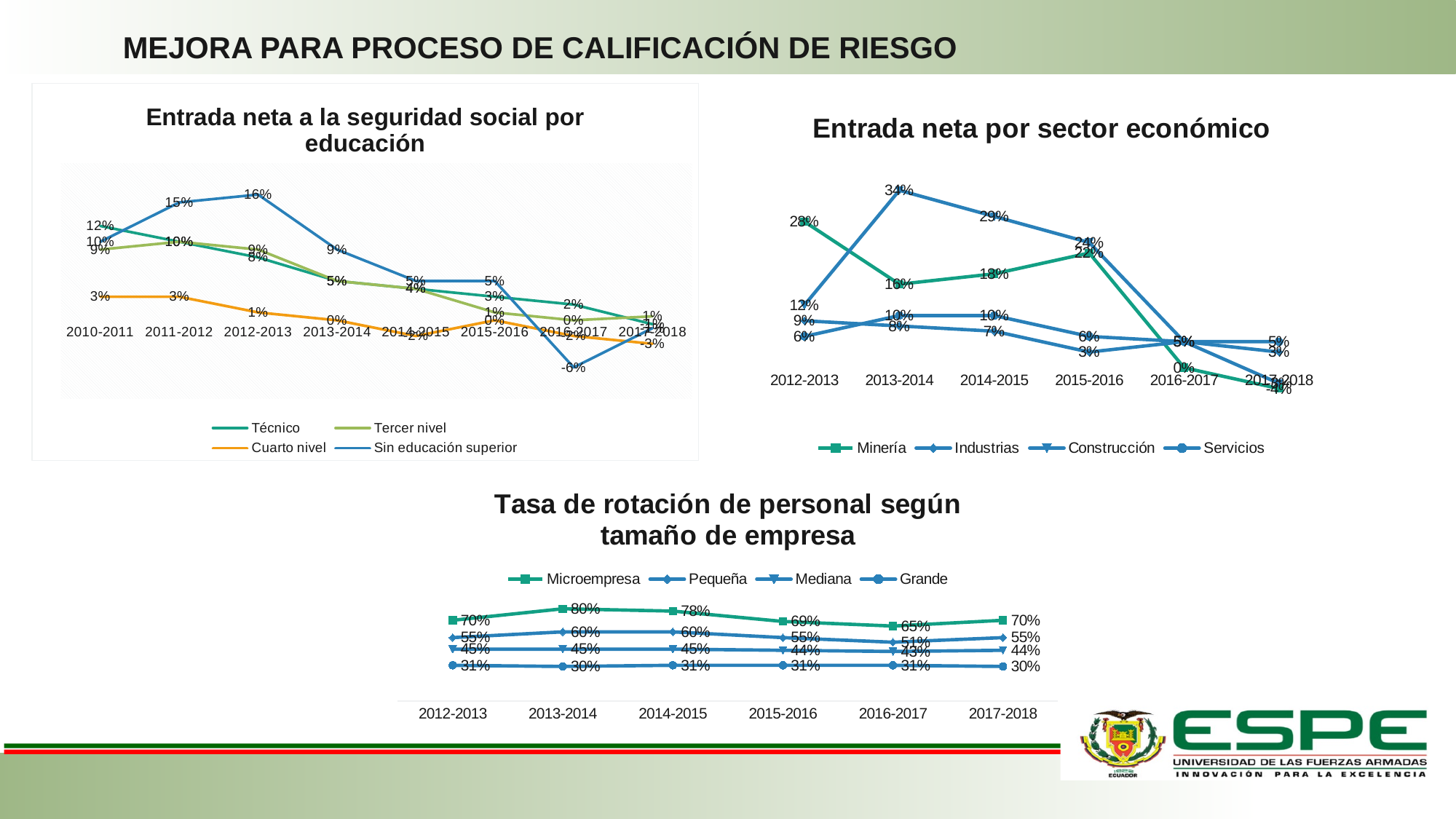
In the chart 'Tasa de rotación de personal según tamaño de empresa', what is the value for Grande in 2017-2018? 30% In the chart 'Tasa de rotación de personal según tamaño de empresa', in which period is the Microempresa value highest? 2013-2014 In the chart 'Entrada neta a la seguridad social por educación', in which period is the Sin educación superior value lowest? 2016-2017 In the chart 'Tasa de rotación de personal según tamaño de empresa', what is the value for Microempresa in 2013-2014? 80% In the chart 'Entrada neta por sector económico', what is the value for Minería in 2012-2013? 28% How many series does the legend of 'Tasa de rotación de personal según tamaño de empresa' list? 4 In the chart 'Tasa de rotación de personal según tamaño de empresa', what is the difference between Microempresa and Grande in 2012-2013? 39 percentage points In the chart 'Entrada neta a la seguridad social por educación', what is the value for Sin educación superior in 2012-2013? 16% How many periods are shown on the x axis of 'Tasa de rotación de personal según tamaño de empresa'? 6 In the chart 'Entrada neta por sector económico', which is larger in 2014-2015: Minería or Construcción? Construcción In the chart 'Entrada neta por sector económico', what is the value for Construcción in 2013-2014? 34% What kind of chart is 'Tasa de rotación de personal según tamaño de empresa'? Line chart